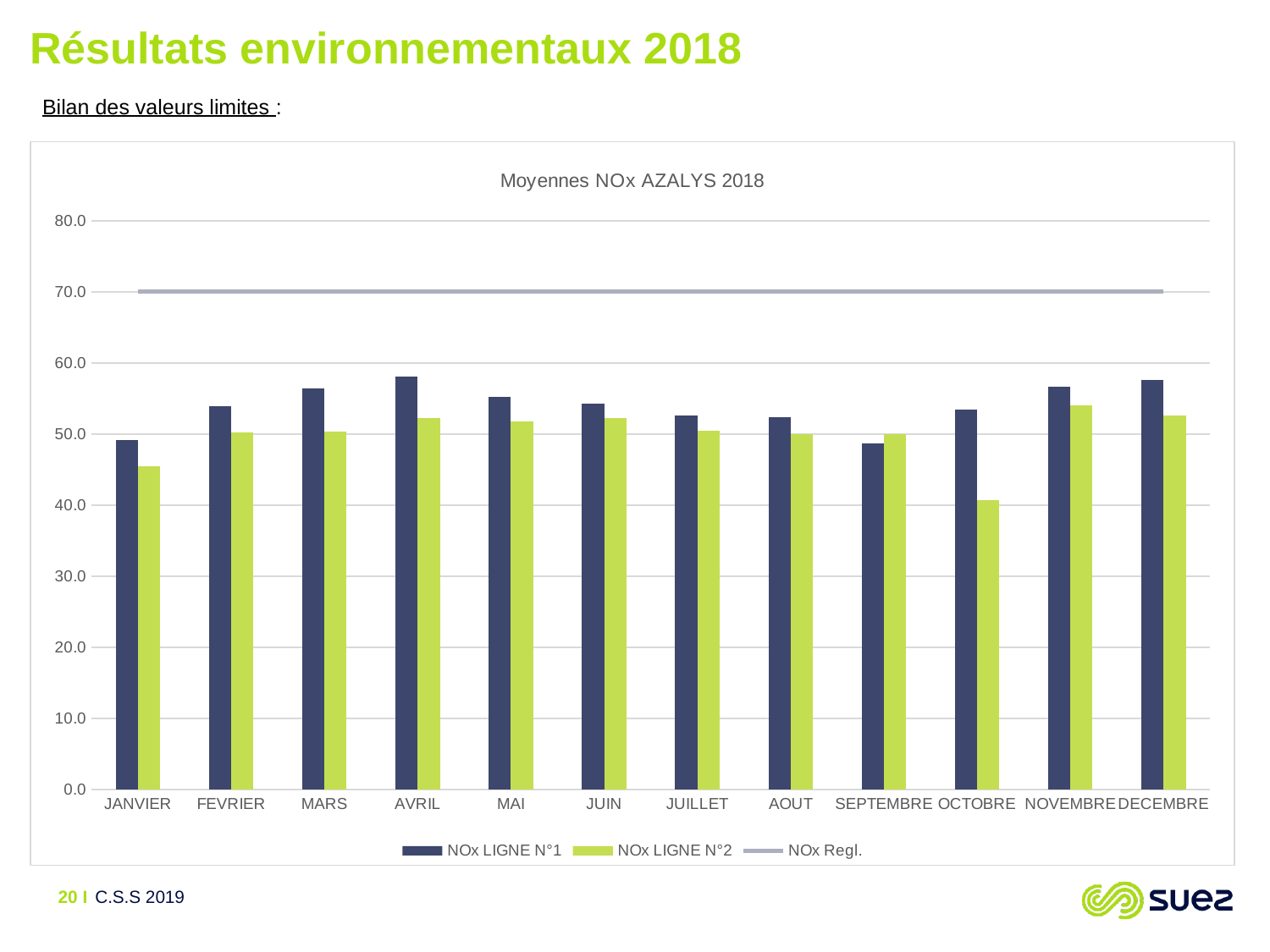
Is the NOx LIGNE N°1 value for AVRIL greater or less than 60.0? less What is the value of the NOx Regl. line? 70.0 In which month is the NOx LIGNE N°2 value highest? NOVEMBRE What is the title of the chart? Moyennes NOx AZALYS 2018 What kind of chart is shown on the slide? bar chart In JANVIER, which is larger: NOx LIGNE N°1 or NOx LIGNE N°2? NOx LIGNE N°1 In OCTOBRE, which is larger: NOx LIGNE N°1 or NOx LIGNE N°2? NOx LIGNE N°1 In which month is the NOx LIGNE N°2 value lowest? OCTOBRE Which series is drawn as a horizontal line rather than bars? NOx Regl. Is the NOx LIGNE N°2 value for JANVIER greater or less than 50.0? less How many series does the legend list? 3 How many months are shown on the x axis? 12